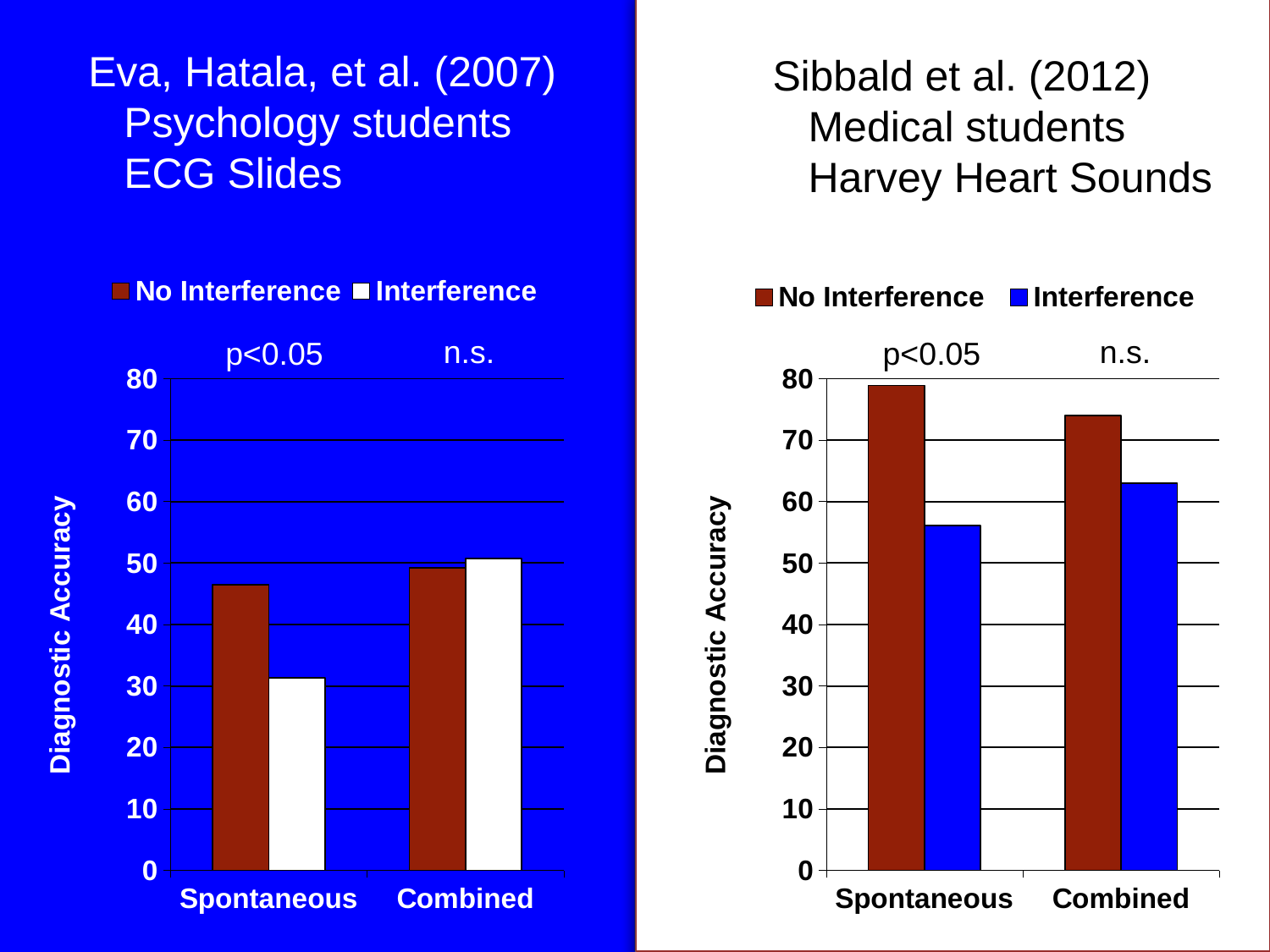
In the right chart (Sibbald et al. 2012), which is larger for Combined: No Interference or Interference? No Interference In the right chart (Sibbald et al. 2012), is the No Interference value for Spontaneous greater or less than 70? greater In the left chart (Eva, Hatala, et al. 2007), is the Interference value for Spontaneous greater or less than 40? less In the right chart (Sibbald et al. 2012), which bar is the highest? Spontaneous, No Interference In the right chart (Sibbald et al. 2012), is the Interference value for Combined greater or less than 50? greater In the left chart (Eva, Hatala, et al. 2007), which bar is the lowest? Spontaneous, Interference In the left chart (Eva, Hatala, et al. 2007), which is larger for Spontaneous: No Interference or Interference? No Interference What type of chart is the left chart (Eva, Hatala, et al. 2007)? bar chart How many series does the legend of the right chart (Sibbald et al. 2012) list? 2 How many categories are shown on the x axis of the left chart (Eva, Hatala, et al. 2007)? 2